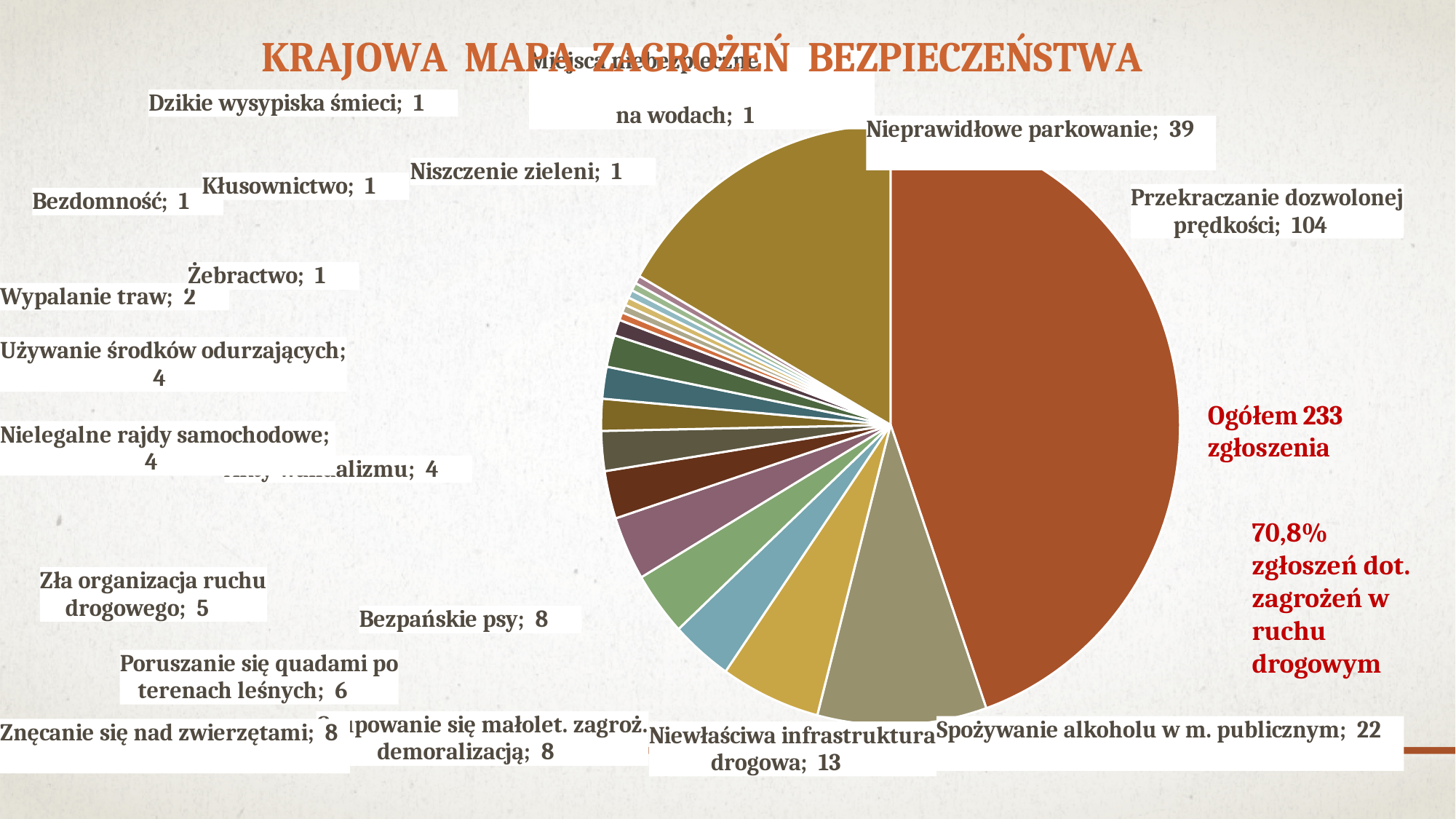
What is the value for "Spożywanie alkoholu w m. publicznym"? 22 Which category has the largest slice of the pie? Przekraczanie dozwolonej prędkości What type of chart is shown on the slide? pie chart What percentage of reports concerning road traffic threats is stated on the slide? 70,8% What is the value for "Niewłaściwa infrastruktura drogowa"? 13 What is the difference between the values for "Przekraczanie dozwolonej prędkości" and "Nieprawidłowe parkowanie"? 65 What is the value for "Poruszanie się quadami po terenach leśnych"? 6 What is the value for "Wypalanie traw"? 2 How many reports are shown for "Przekraczanie dozwolonej prędkości"? 104 What is the value for "Nieprawidłowe parkowanie"? 39 What total number of reports ("Ogółem") is stated next to the pie chart? 233 zgłoszenia Which is larger: the value for "Spożywanie alkoholu w m. publicznym" or for "Niewłaściwa infrastruktura drogowa"? Spożywanie alkoholu w m. publicznym